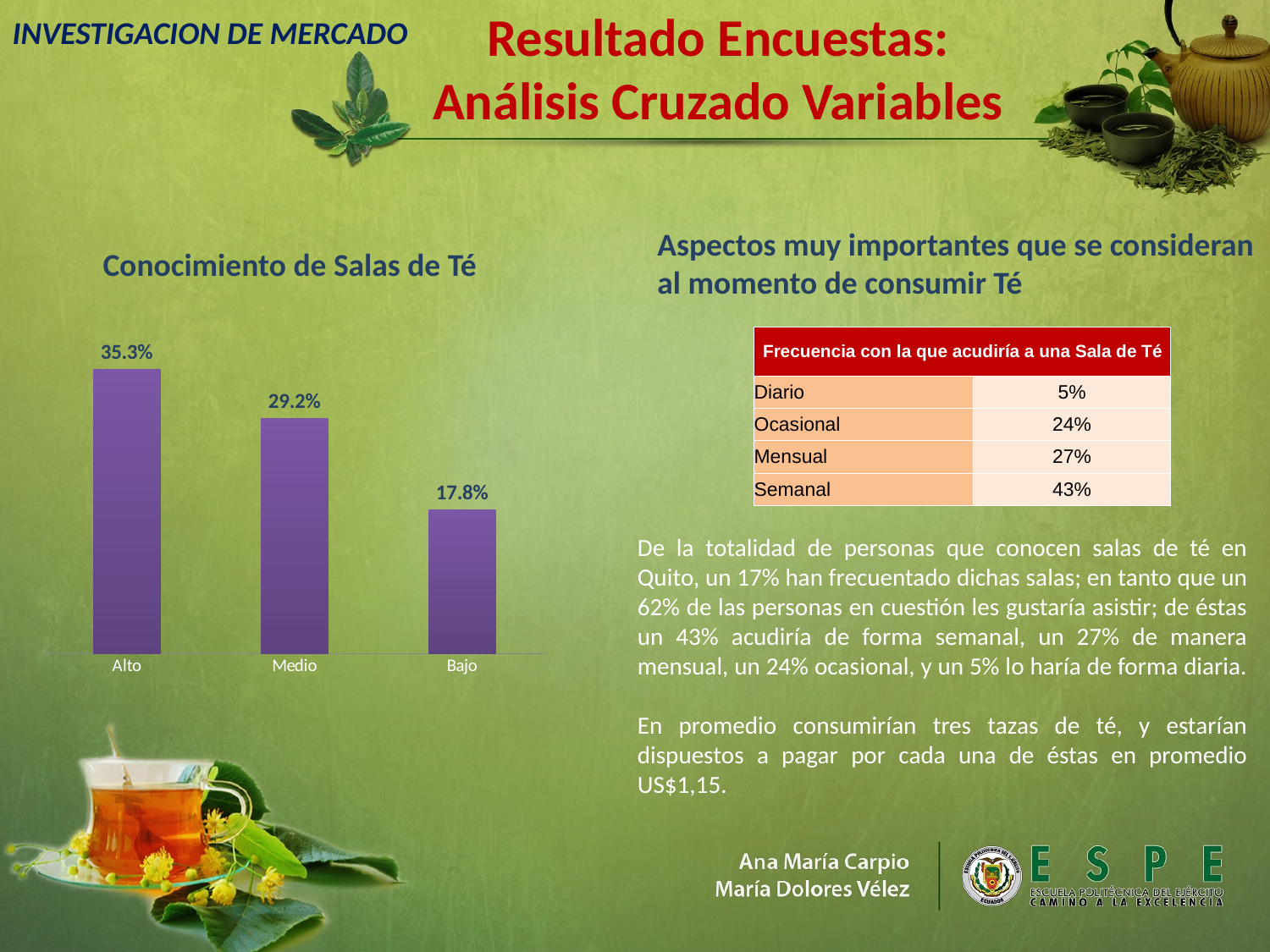
How many categories are shown in the 'Conocimiento de Salas de Té' chart? 3 In the 'Conocimiento de Salas de Té' chart, do the values rise or fall from Alto to Bajo? Fall In the 'Conocimiento de Salas de Té' chart, which category has the highest value? Alto In the 'Conocimiento de Salas de Té' chart, what is the value for Bajo? 17.8% In the 'Conocimiento de Salas de Té' chart, what is the value for Medio? 29.2% In the 'Conocimiento de Salas de Té' chart, what is the difference between the values for Alto and Medio? 6.1% In the 'Conocimiento de Salas de Té' chart, which category has the lowest value? Bajo In the 'Conocimiento de Salas de Té' chart, what is the difference between the values for Alto and Bajo? 17.5% What is the title of the bar chart on the left of the slide? Conocimiento de Salas de Té In the 'Conocimiento de Salas de Té' chart, which is larger, the value for Medio or the value for Bajo? Medio In the 'Conocimiento de Salas de Té' chart, what is the value for Alto? 35.3% What kind of chart is 'Conocimiento de Salas de Té'? Bar chart